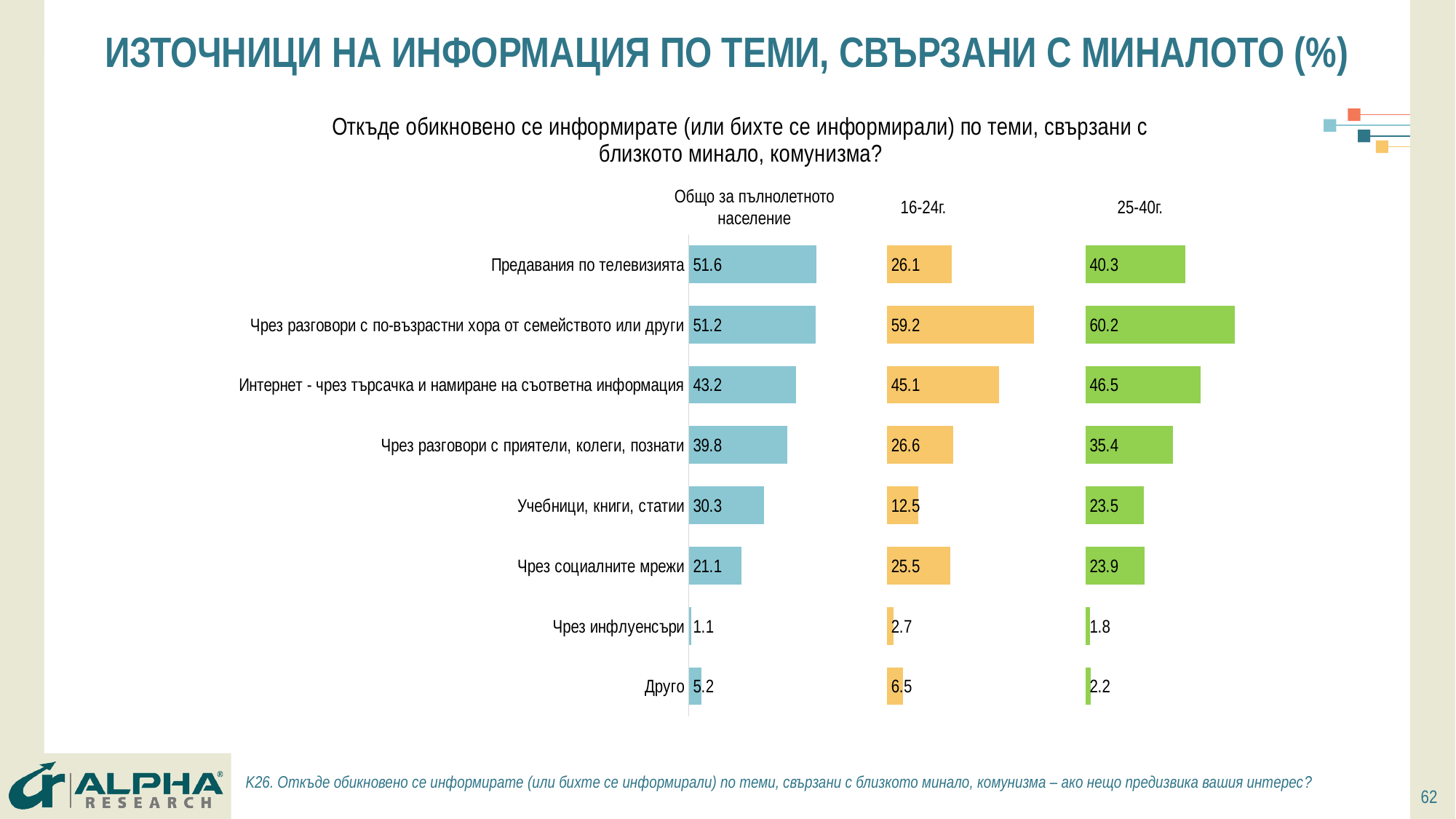
In the '16-24г.' panel, which category has the highest value? Чрез разговори с по-възрастни хора от семейството или други How many categories are shown in each panel of the chart? 8 In the '16-24г.' panel, what is the difference between 'Предавания по телевизията' and 'Чрез разговори с приятели, колеги, познати'? 0.5 In the '16-24г.' panel, what is the value for 'Учебници, книги, статии'? 12.5 How many age/population groups (panels) does the chart show? 3 What kind of chart is shown on the slide? Bar chart What colour are the bars in the '25-40г.' panel? Green In the 'Общо за пълнолетното население' panel, which category has the lowest value? Чрез инфлуенсъри For 'Интернет - чрез търсачка и намиране на съответна информация', which is larger: the '16-24г.' value or the '25-40г.' value? 25-40г. In the 'Общо за пълнолетното население' panel, what is the value for 'Предавания по телевизията'? 51.6 In the '25-40г.' panel, what is the difference between 'Чрез разговори с по-възрастни хора от семейството или други' and 'Предавания по телевизията'? 19.9 In the '25-40г.' panel, what is the value for 'Чрез социалните мрежи'? 23.9